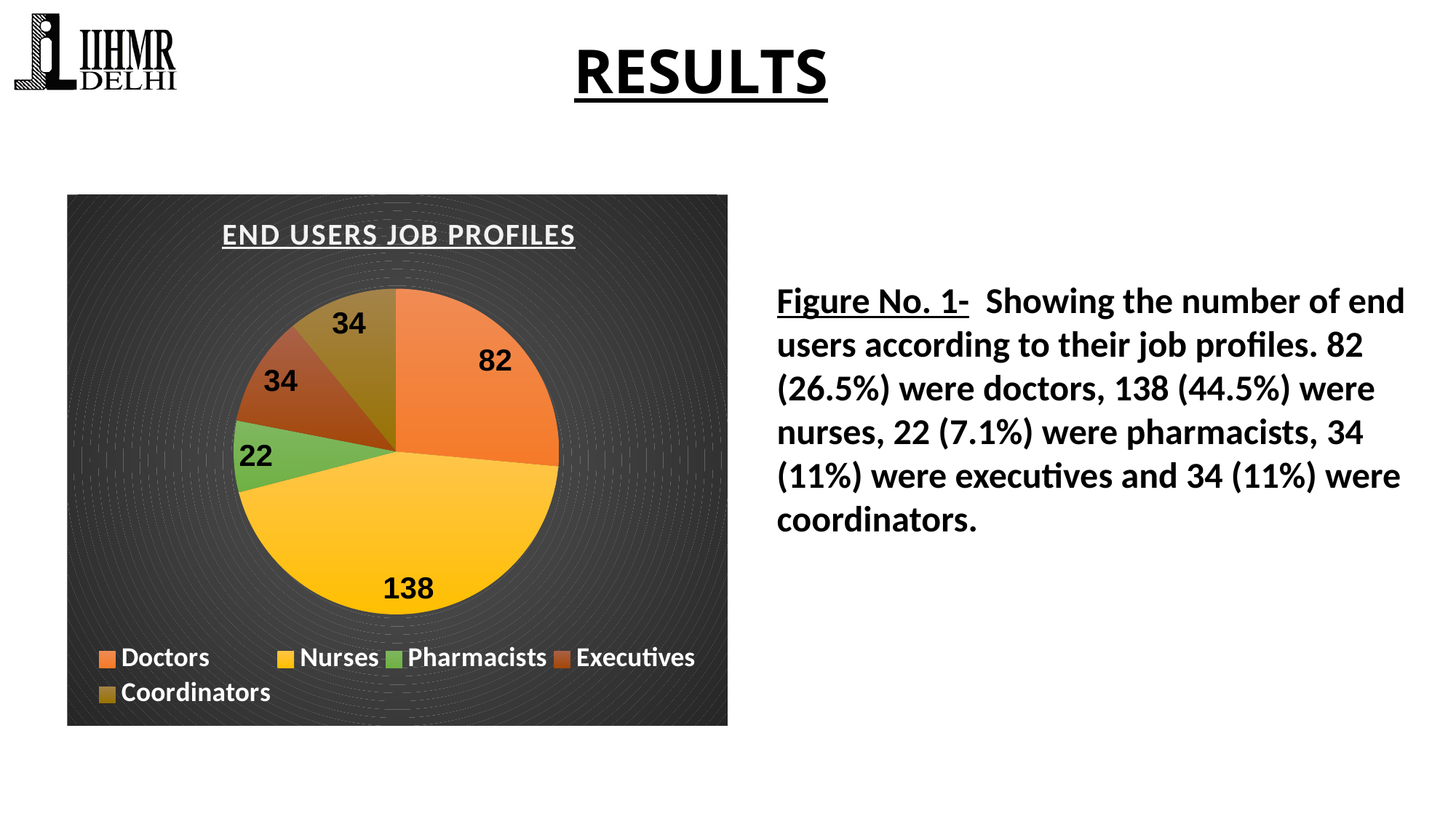
What is the value for Executives in the pie chart? 34 Which is larger, the value for Doctors or the value for Coordinators? Doctors What is the difference between the number of Nurses and the number of Doctors? 56 What type of chart is shown on the slide? pie chart Which job profile has the smallest slice of the pie? Pharmacists Which job profile has the largest slice of the pie? Nurses What is the value for Doctors in the pie chart? 82 What is the value for Nurses in the pie chart? 138 What is the title of the chart? END USERS JOB PROFILES How many job profile categories does the pie chart show? 5 What share of the pie do Nurses represent? 44.5% What is the value for Pharmacists in the pie chart? 22